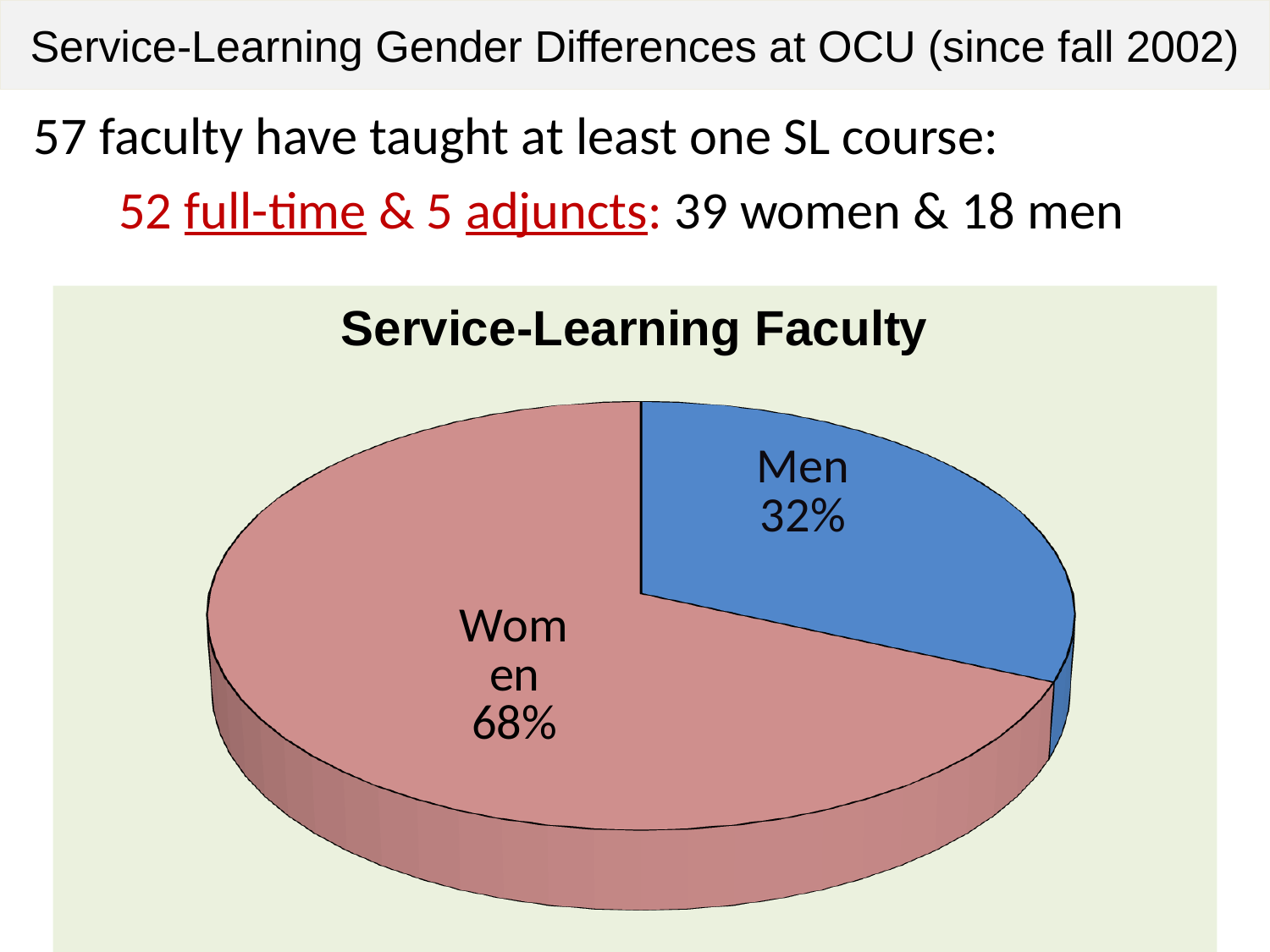
What share of the pie is labelled Men? 32% Which slice of the pie is the smallest? Men Which slice is larger, Women or Men? Women How many slices does the pie chart have? 2 What share of the pie is labelled Women? 68% Which slice of the pie is the largest? Women What is the title of the chart? Service-Learning Faculty What colour is the Men slice of the pie? blue What is the difference in percentage points between the Women slice and the Men slice? 36 What kind of chart is shown on the slide? pie chart